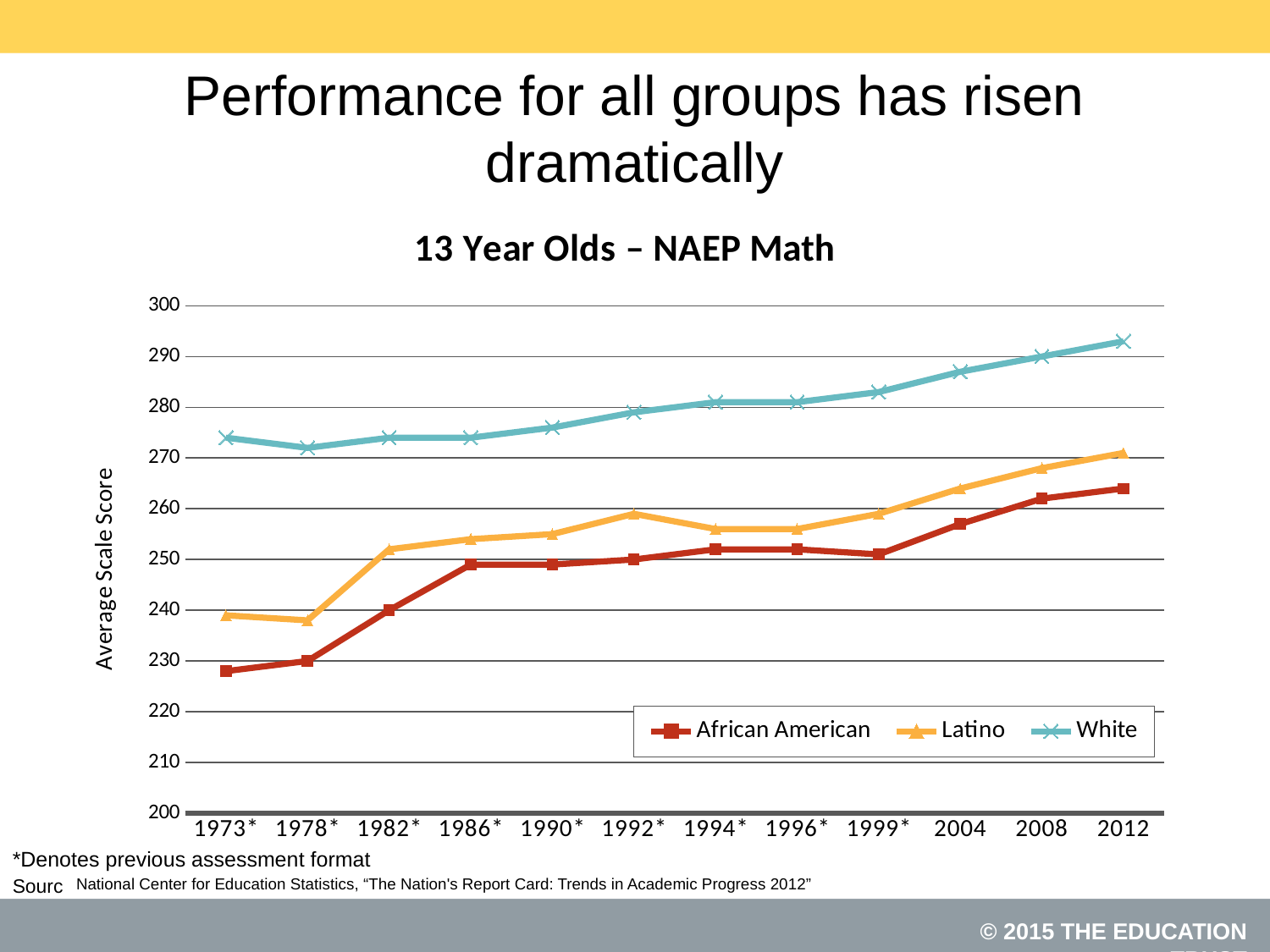
Which group has the lowest average scale score in 1973*? African American Which is larger in 1986*, the Latino score or the African American score? Latino What is the title of the chart? 13 Year Olds – NAEP Math Is the value for Latino in 2012 greater or less than 260? greater What kind of chart is shown on the slide? line chart Does the White series rise or fall from 1999* to 2012? rise How many series does the legend list? 3 Which group has the highest average scale score in 2012? White How many assessment years are shown on the x axis? 12 What is the label on the vertical axis? Average Scale Score Is the value for White in 1973* greater or less than 270? greater Is the value for African American in 2012 greater or less than 260? greater